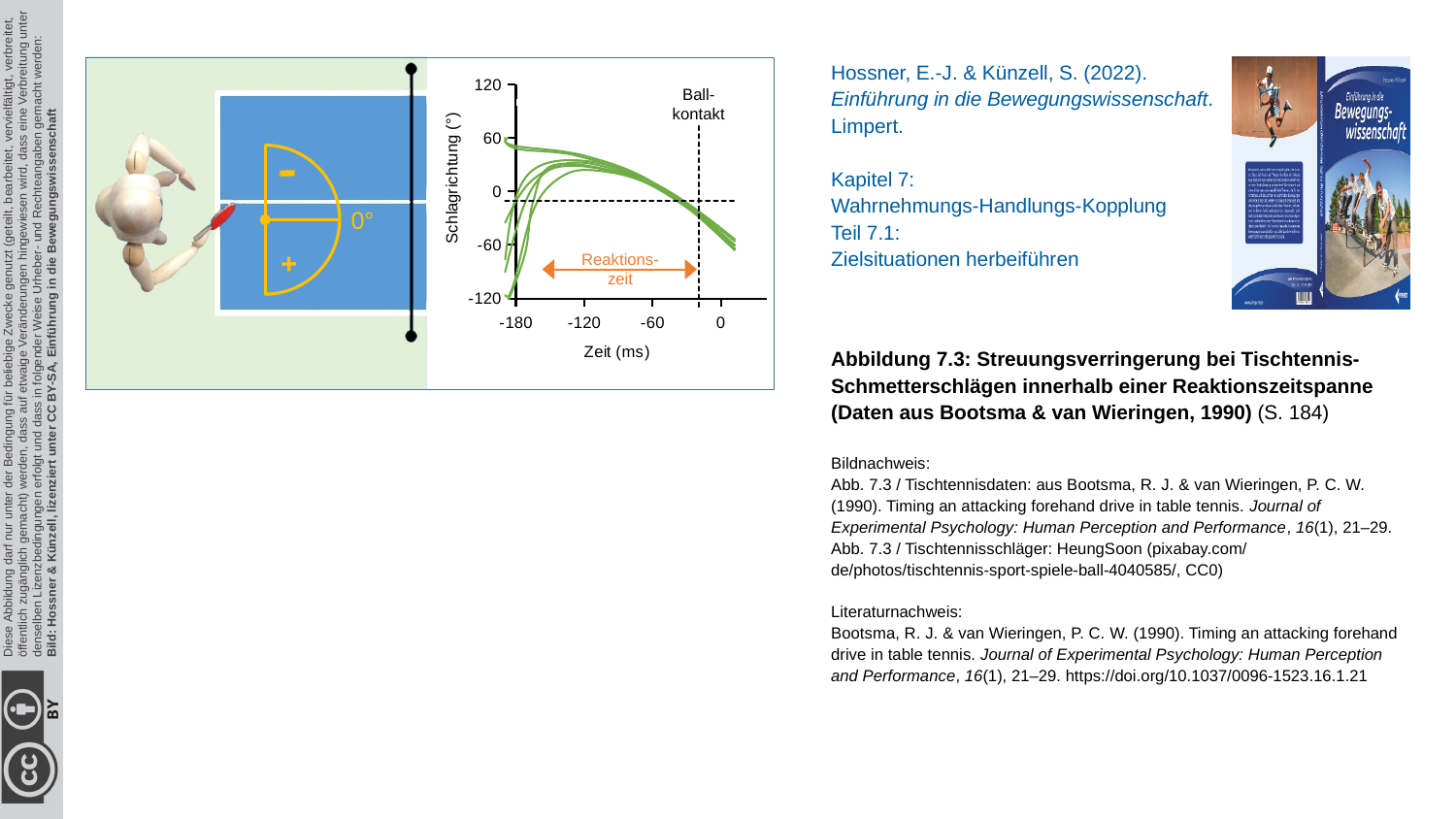
What is the label of the vertical axis of the chart? Schlagrichtung (°) At Zeit = 0 ms, are the Schlagrichtung values of the green lines greater or less than -120? greater What kind of chart is shown on the left of the slide? line chart What is the label of the horizontal axis of the chart? Zeit (ms) Is the spread of the green lines larger at Zeit = -180 ms or at Zeit = 0 ms? -180 ms As Zeit approaches 0 ms, do the green lines converge or diverge? converge At Zeit = 0 ms, are the Schlagrichtung values of the green lines greater or less than 60? less